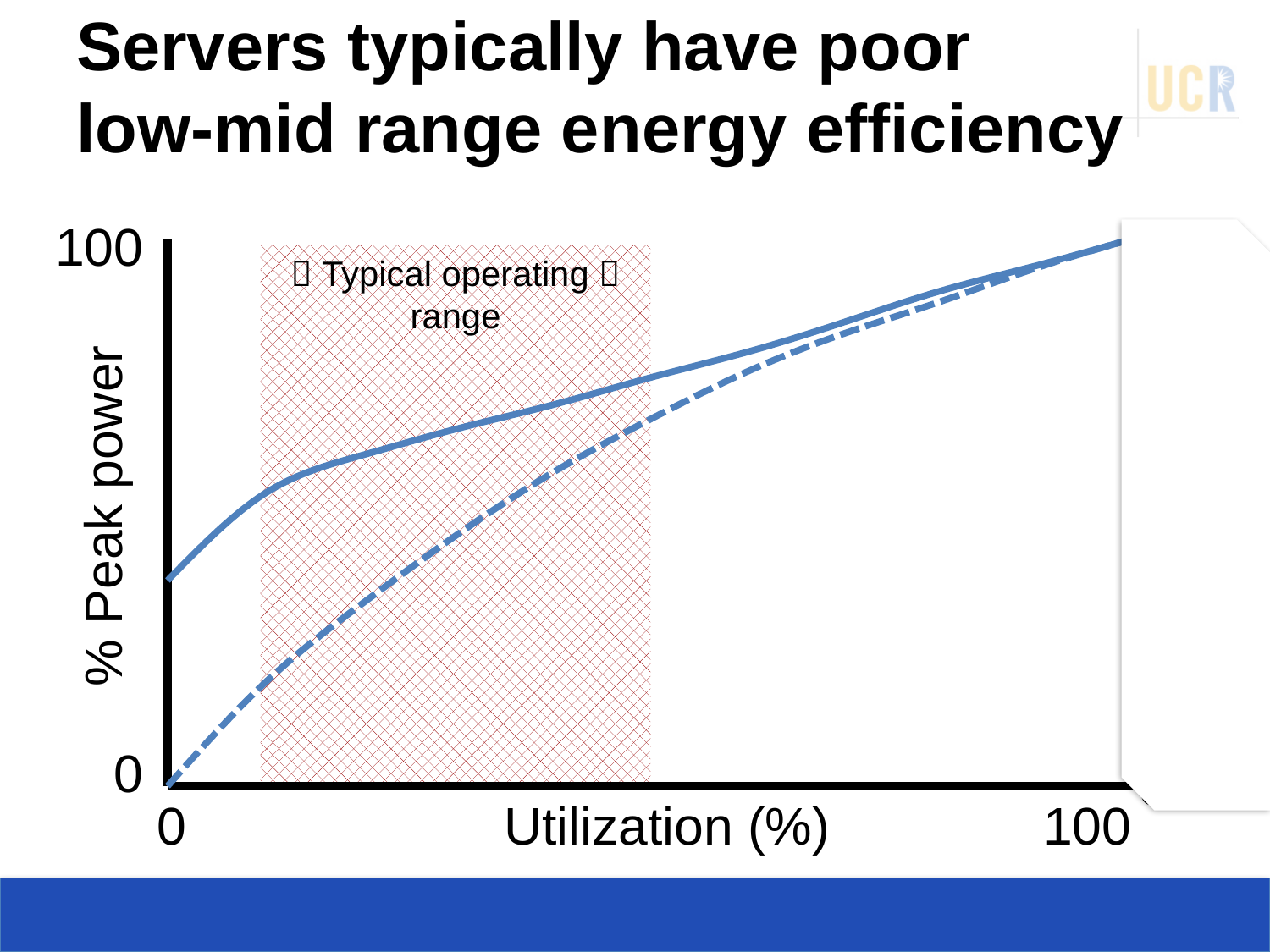
What kind of chart is shown on the slide? line chart What is the value of the dashed line at 0% utilization? 0 What is the label of the y axis? % Peak power Does the solid line rise or fall as utilization increases? rise Is the value of the solid line at 0% utilization greater or less than 0? greater Is the value of the solid line at 0% utilization greater or less than 100? less Within the shaded typical operating range, which line is higher, the solid line or the dashed line? the solid line What value does the solid line reach at 100% utilization? 100 Does the dashed line rise or fall as utilization increases? rise How many lines are plotted on the chart? 2 At 0% utilization, which line has the higher % Peak power, the solid line or the dashed line? the solid line What is the label of the x axis? Utilization (%)